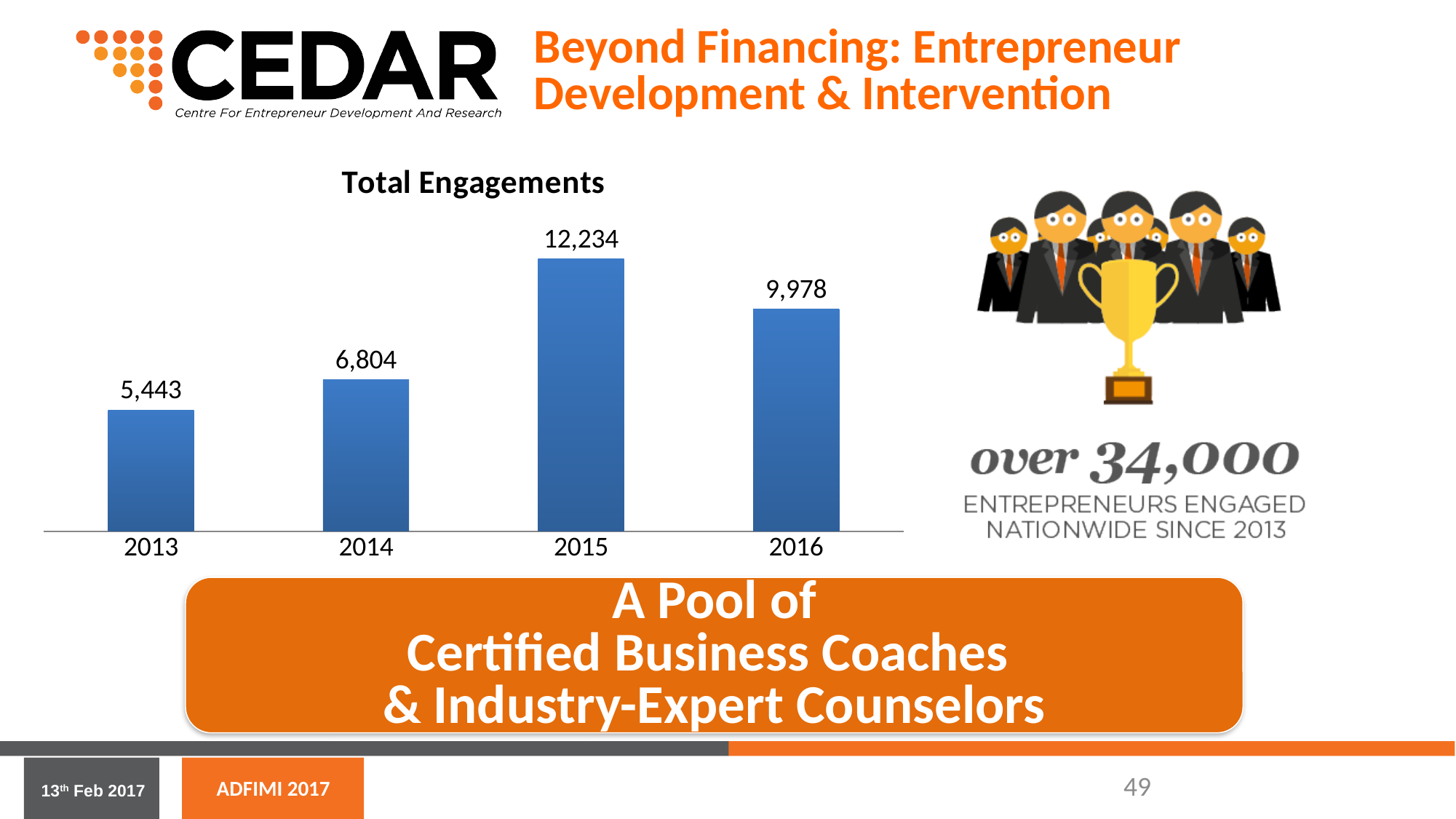
What is the difference in Total Engagements between 2015 and 2016? 2,256 What is the value of Total Engagements for 2016? 9,978 What is the title of the chart on the slide? Total Engagements How many years are shown in the Total Engagements chart? 4 What is the value of Total Engagements for 2013? 5,443 Which year has the lowest Total Engagements? 2013 Which year has more Total Engagements, 2014 or 2016? 2016 What is the value of Total Engagements for 2015? 12,234 What kind of chart is used to show Total Engagements? Bar chart What is the difference in Total Engagements between 2014 and 2013? 1,361 Which year has the highest Total Engagements? 2015 What is the value of Total Engagements for 2014? 6,804